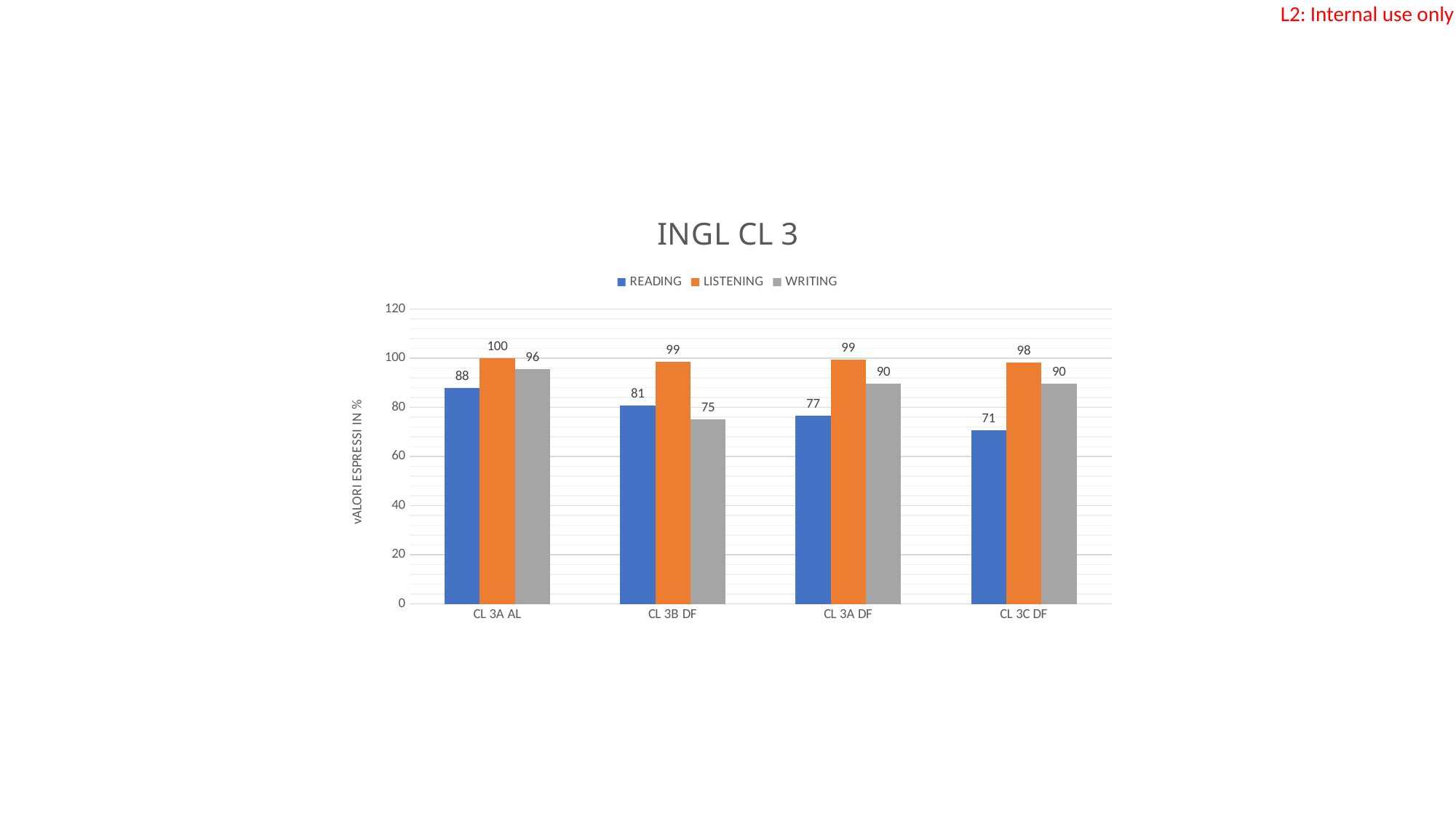
What is the WRITING value for CL 3B DF? 75 What is the difference between the READING values for CL 3A AL and CL 3C DF? 17 What is the LISTENING value for CL 3C DF? 98 How many categories are shown on the x axis? 4 What is the READING value for CL 3A AL? 88 How many series does the legend list? 3 What is the difference between the LISTENING and WRITING values for CL 3B DF? 24 What is the title of the chart? INGL CL 3 What kind of chart is shown? Bar chart Which is larger for CL 3A DF, the READING value or the WRITING value? WRITING Which category has the lowest READING value? CL 3C DF Which category has the highest LISTENING value? CL 3A AL